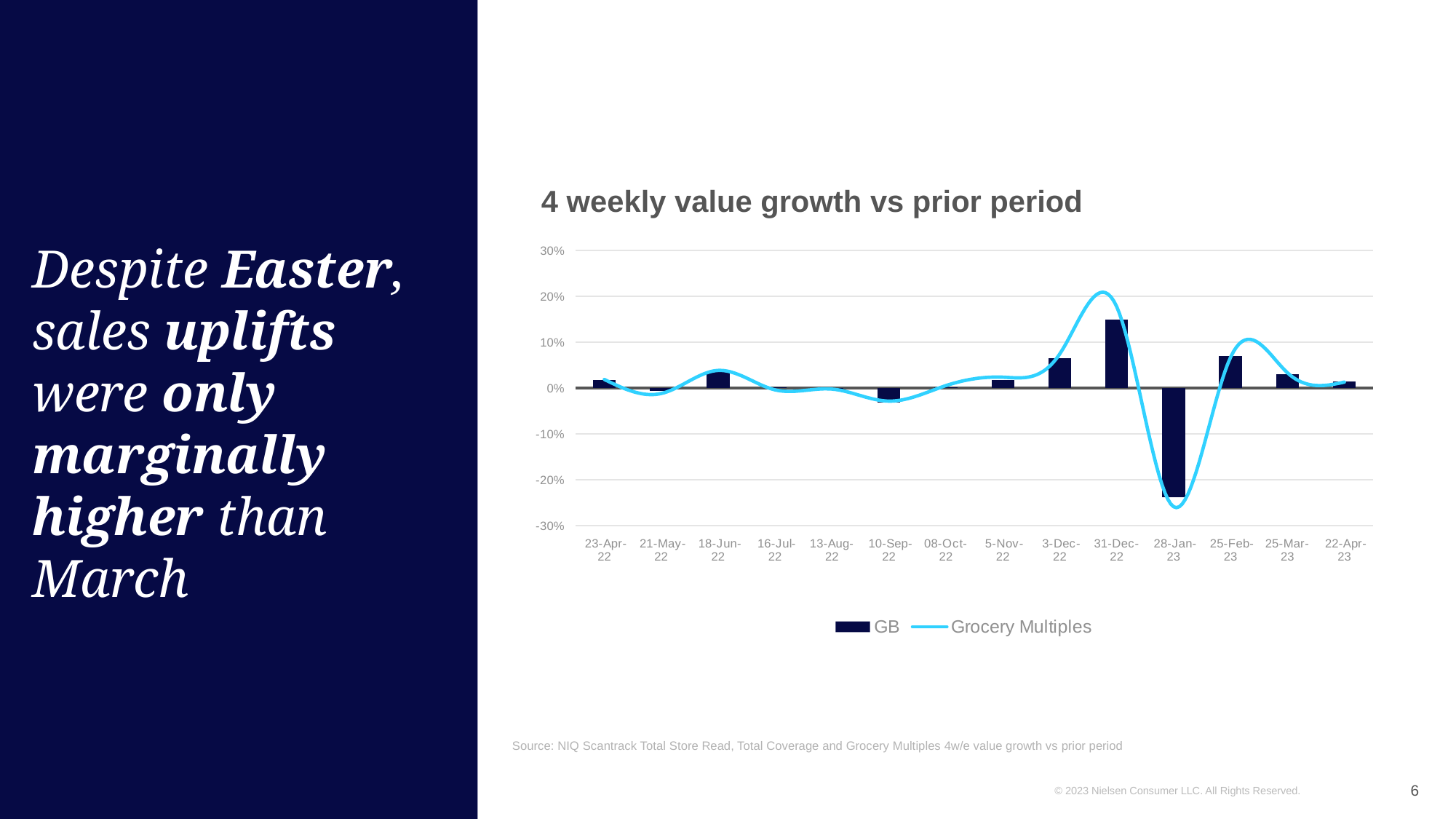
Is the Grocery Multiples value for 28-Jan-23 greater or less than -20%? less Is the GB value for 28-Jan-23 greater or less than -10%? less Is the GB value for 31-Dec-22 greater or less than 10%? greater How many series does the legend list? 2 Which period has the highest GB value? 31-Dec-22 How many periods are shown on the x axis? 14 Which series is drawn as a line? Grocery Multiples Between 31-Dec-22 and 28-Jan-23, does the GB value rise or fall? fall What is the title of the chart? 4 weekly value growth vs prior period What kind of chart is shown on the slide? A combined bar and line chart Which is larger, the GB value for 31-Dec-22 or for 25-Feb-23? 31-Dec-22 Which period has the lowest GB value? 28-Jan-23